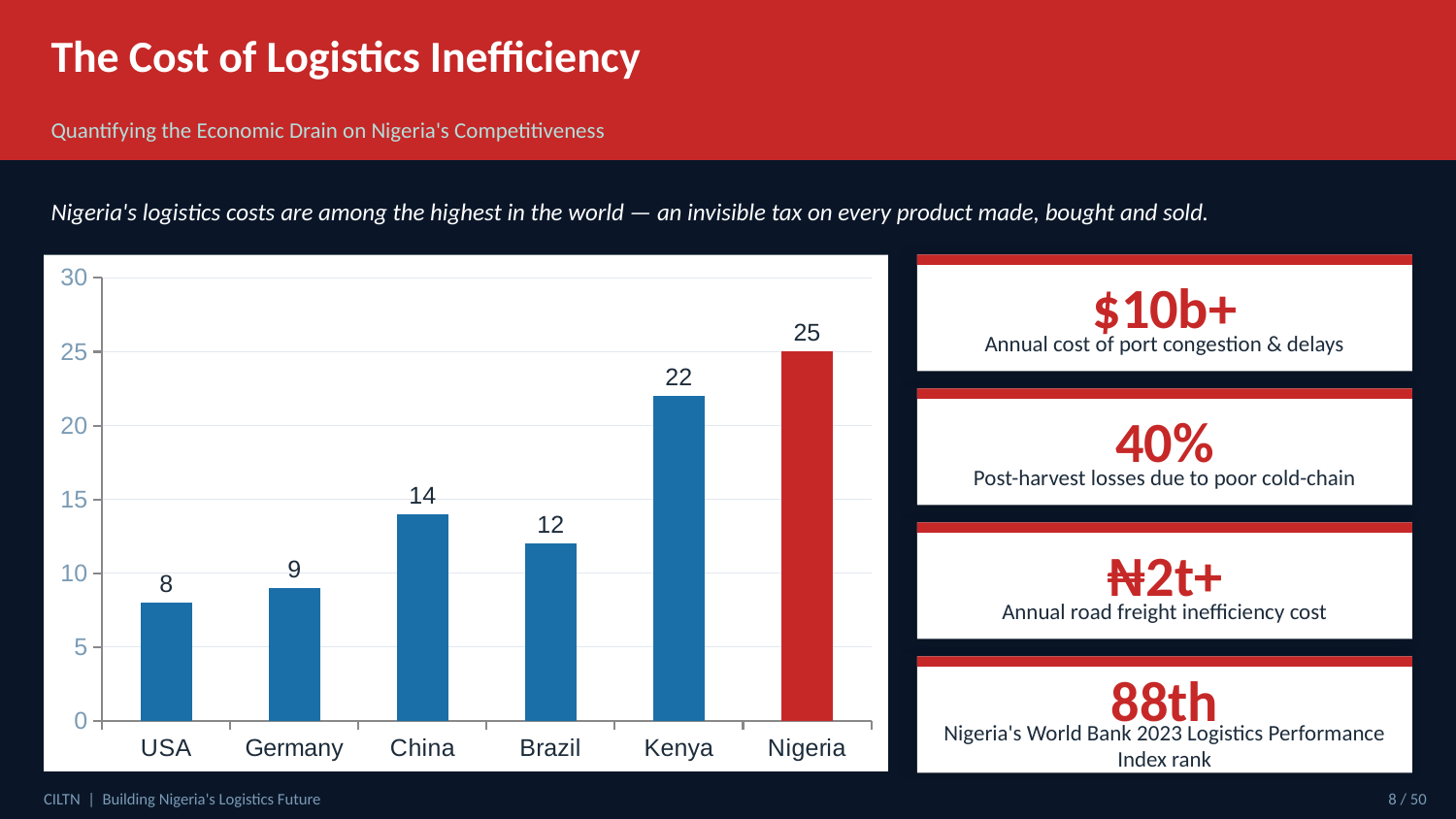
Which country has the lowest value in the bar chart? USA What is the value for Kenya in the bar chart? 22 How many countries are shown in the bar chart? 6 Which country has the highest value in the bar chart? Nigeria What is the value for Nigeria in the bar chart? 25 Which has a larger value, Germany or Brazil? Brazil What is the difference between the values for China and Brazil? 2 What kind of chart is shown on the slide? Bar chart Is the value for Kenya greater or less than 20? greater Which bar in the chart is coloured red rather than blue? Nigeria What is the value for USA in the bar chart? 8 What is the difference between the values for Nigeria and USA? 17